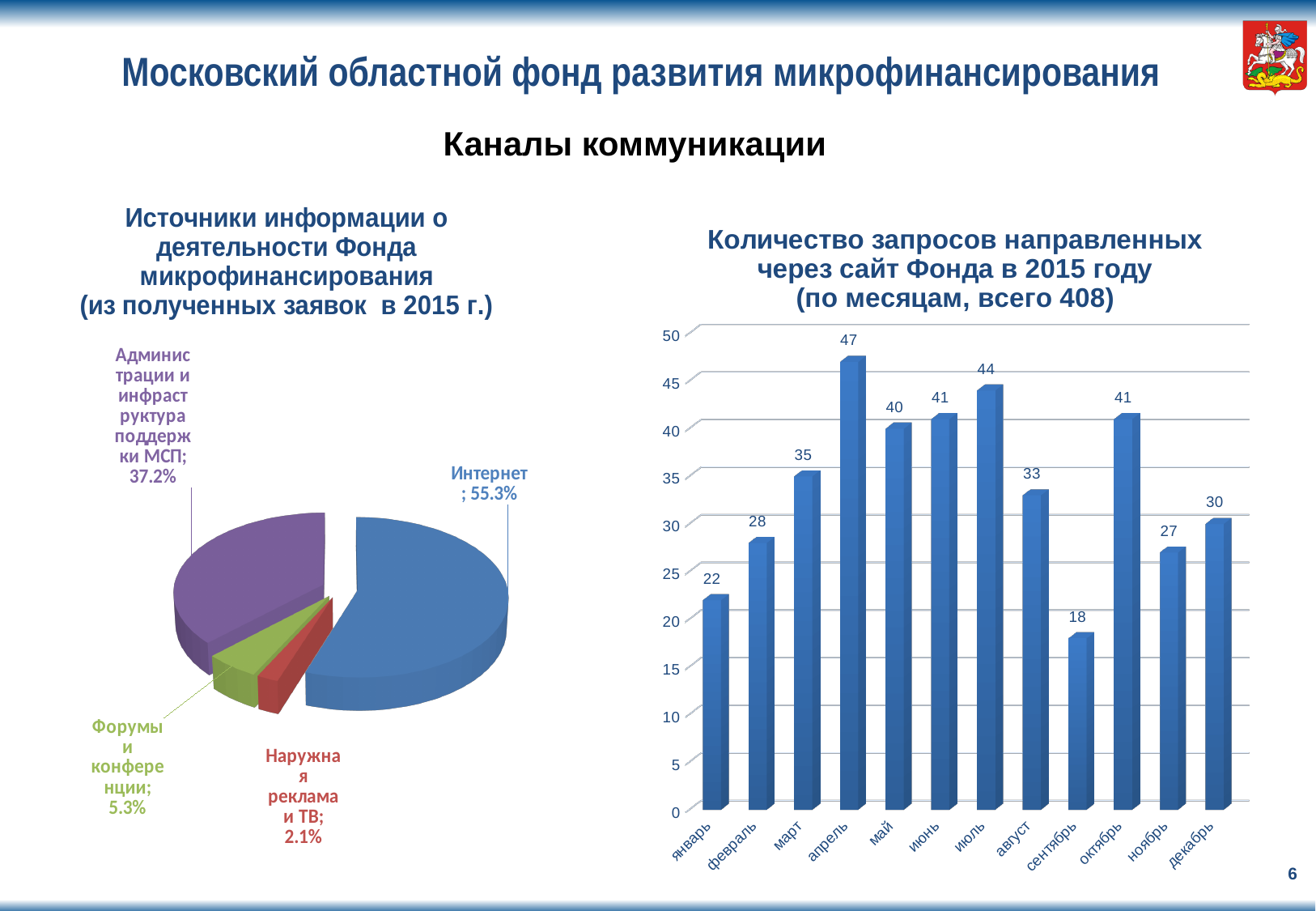
In the bar chart on the right, how many requests were sent through the Fund's website in апрель? 47 In the bar chart on the right, what is the difference between the values for июль and январь? 22 In the bar chart on the right, what is the value for сентябрь? 18 In the pie chart on the left, what is the share for Форумы и конференции? 5.3% What type of chart is the chart on the right of the slide? bar chart In the pie chart on the left, what share of applications came from Интернет? 55.3% In the bar chart on the right, which month has the lowest number of requests? сентябрь What type of chart is the chart on the left of the slide? pie chart In the bar chart on the right, how many months (categories) are shown? 12 In the pie chart on the left, which source has the smallest share? Наружная реклама и ТВ In the bar chart on the right, which is larger: the value for март or the value for декабрь? март In the bar chart on the right, which month has the highest number of requests? апрель